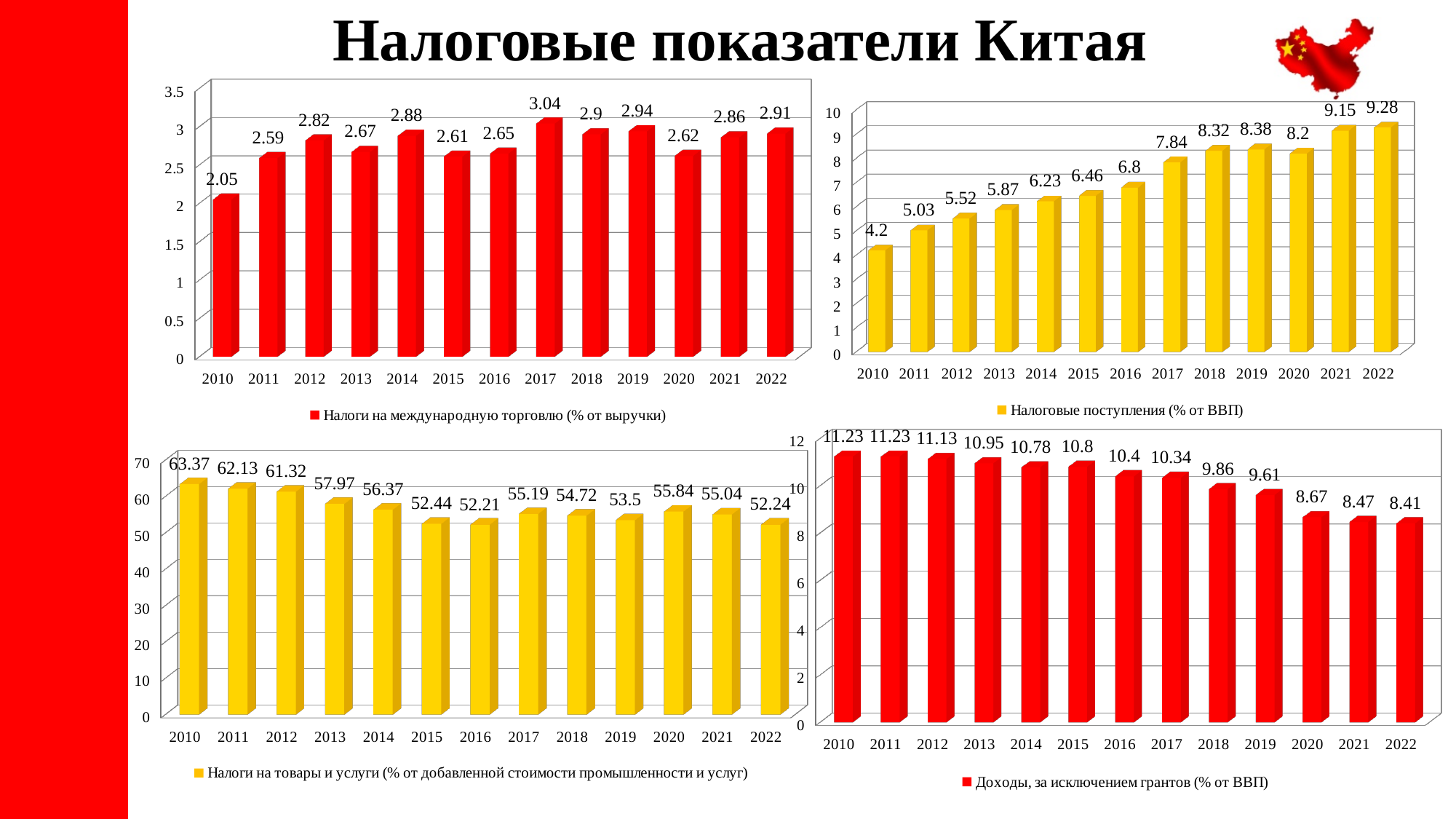
How many years are shown on the x axis of the bottom-right chart (Доходы, за исключением грантов)? 13 In the top-left chart (Налоги на международную торговлю), which year has the lowest value? 2010 In the top-right chart (Налоговые поступления, % от ВВП), what is the value for 2022? 9.28 What type of chart is the top-left chart (Налоги на международную торговлю)? bar chart In the bottom-left chart (Налоги на товары и услуги), what is the value for 2016? 52.21 In the top-right chart (Налоговые поступления, % от ВВП), do the values generally rise or fall from 2010 to 2022? rise In the bottom-right chart (Доходы, за исключением грантов), do the values generally rise or fall from 2010 to 2022? fall In the bottom-left chart (Налоги на товары и услуги), which is larger: the value for 2020 or the value for 2021? 2020 In the bottom-right chart (Доходы, за исключением грантов), what is the value for 2019? 9.61 In the top-left chart (Налоги на международную торговлю), what is the value for 2017? 3.04 In the top-right chart (Налоговые поступления, % от ВВП), what is the difference between the 2022 and 2010 values? 5.08 In the bottom-left chart (Налоги на товары и услуги), which year has the highest value? 2010